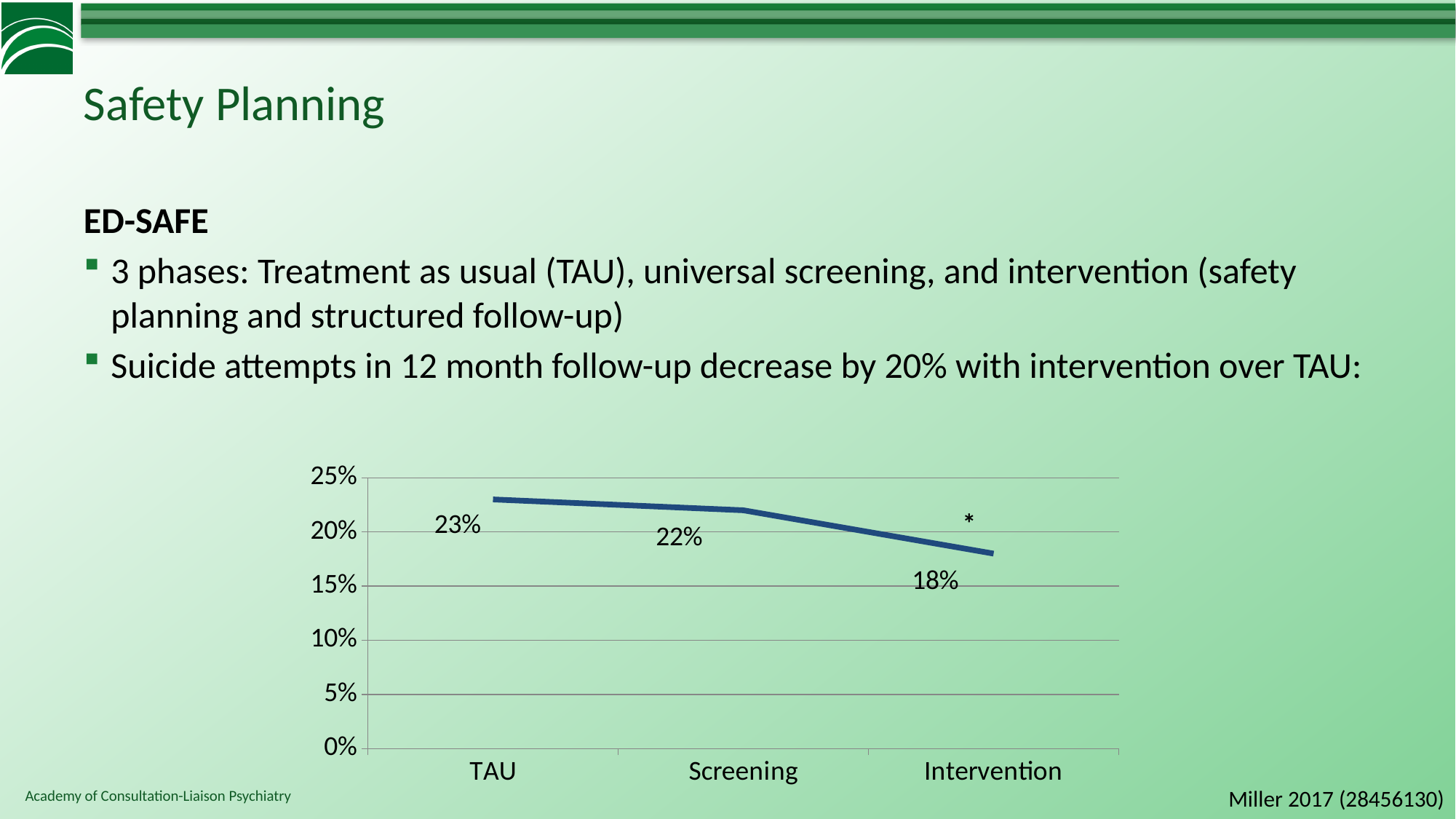
Is the value for Intervention greater or less than 20%? less Do the values rise or fall from TAU to Intervention? fall What is the value for TAU? 23% Which is larger, the value for TAU or the value for Intervention? TAU Which category has the lowest value? Intervention Which category has the highest value? TAU What kind of chart is shown on the slide? line chart What is the difference between the values for Screening and Intervention? 4% What is the value for Intervention? 18% What is the difference between the values for TAU and Intervention? 5% How many categories are shown on the x axis? 3 What is the value for Screening? 22%